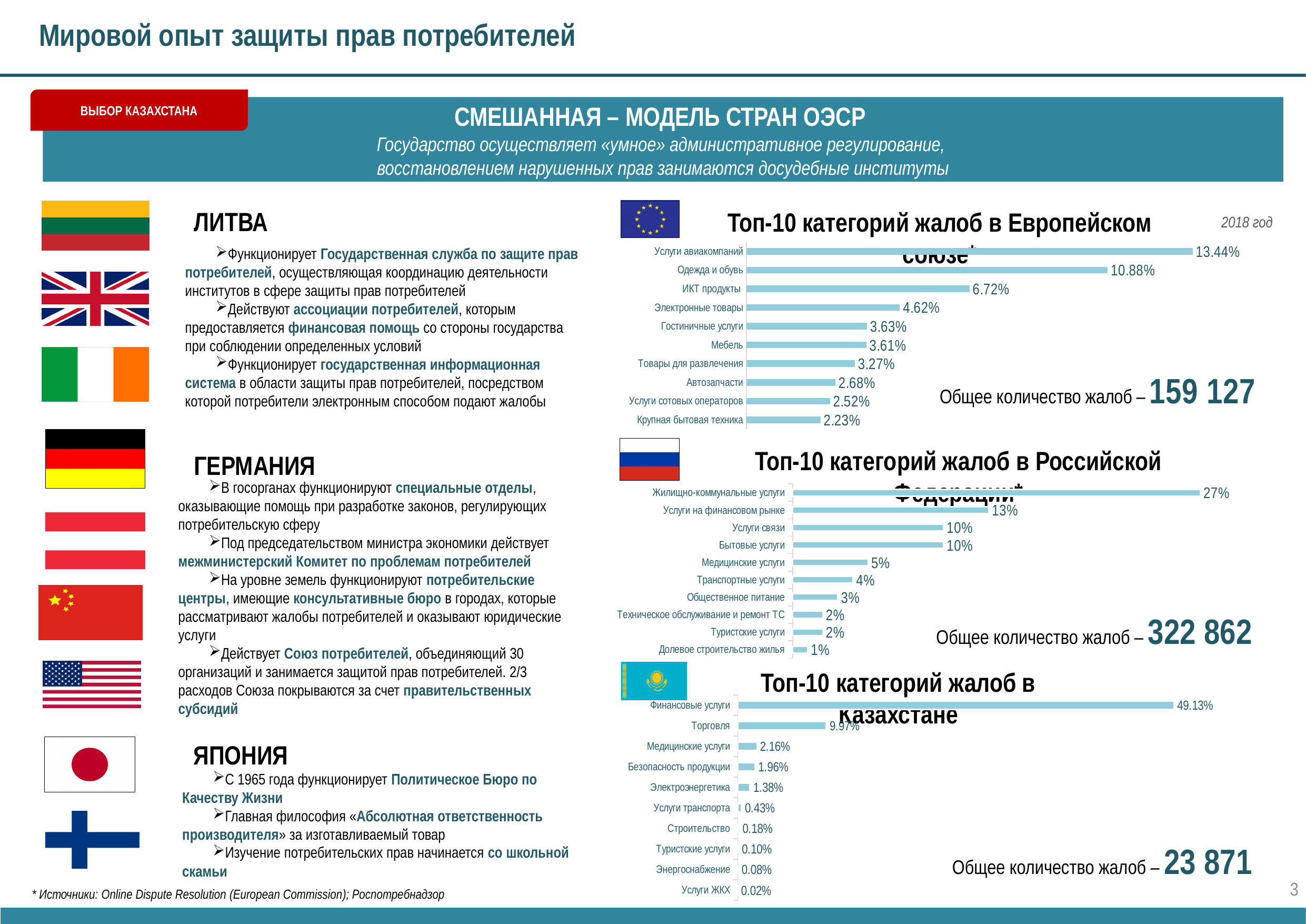
In the chart 'Топ-10 категорий жалоб в Европейском союзе', what is the difference between 'Услуги авиакомпаний' and 'ИКТ продукты'? 6.72% In the chart 'Топ-10 категорий жалоб в Казахстане', what is the value for 'Торговля'? 9.97% In the chart 'Топ-10 категорий жалоб в Российской Федерации', what is the value for 'Медицинские услуги'? 5% In the chart 'Топ-10 категорий жалоб в Европейском союзе', what is the value for 'Одежда и обувь'? 10.88% In the chart 'Топ-10 категорий жалоб в Российской Федерации', which category has the highest value? Жилищно-коммунальные услуги In the chart 'Топ-10 категорий жалоб в Европейском союзе', which category has the highest value? Услуги авиакомпаний In the chart 'Топ-10 категорий жалоб в Российской Федерации', which is larger: 'Услуги на финансовом рынке' or 'Транспортные услуги'? Услуги на финансовом рынке In the chart 'Топ-10 категорий жалоб в Казахстане', what is the difference between 'Финансовые услуги' and 'Торговля'? 39.16% How many categories are shown in the chart 'Топ-10 категорий жалоб в Казахстане'? 10 What type of chart is 'Топ-10 категорий жалоб в Российской Федерации'? Bar chart In the chart 'Топ-10 категорий жалоб в Европейском союзе', which category has the lowest value? Крупная бытовая техника In the chart 'Топ-10 категорий жалоб в Казахстане', which category has the lowest value? Услуги ЖКХ